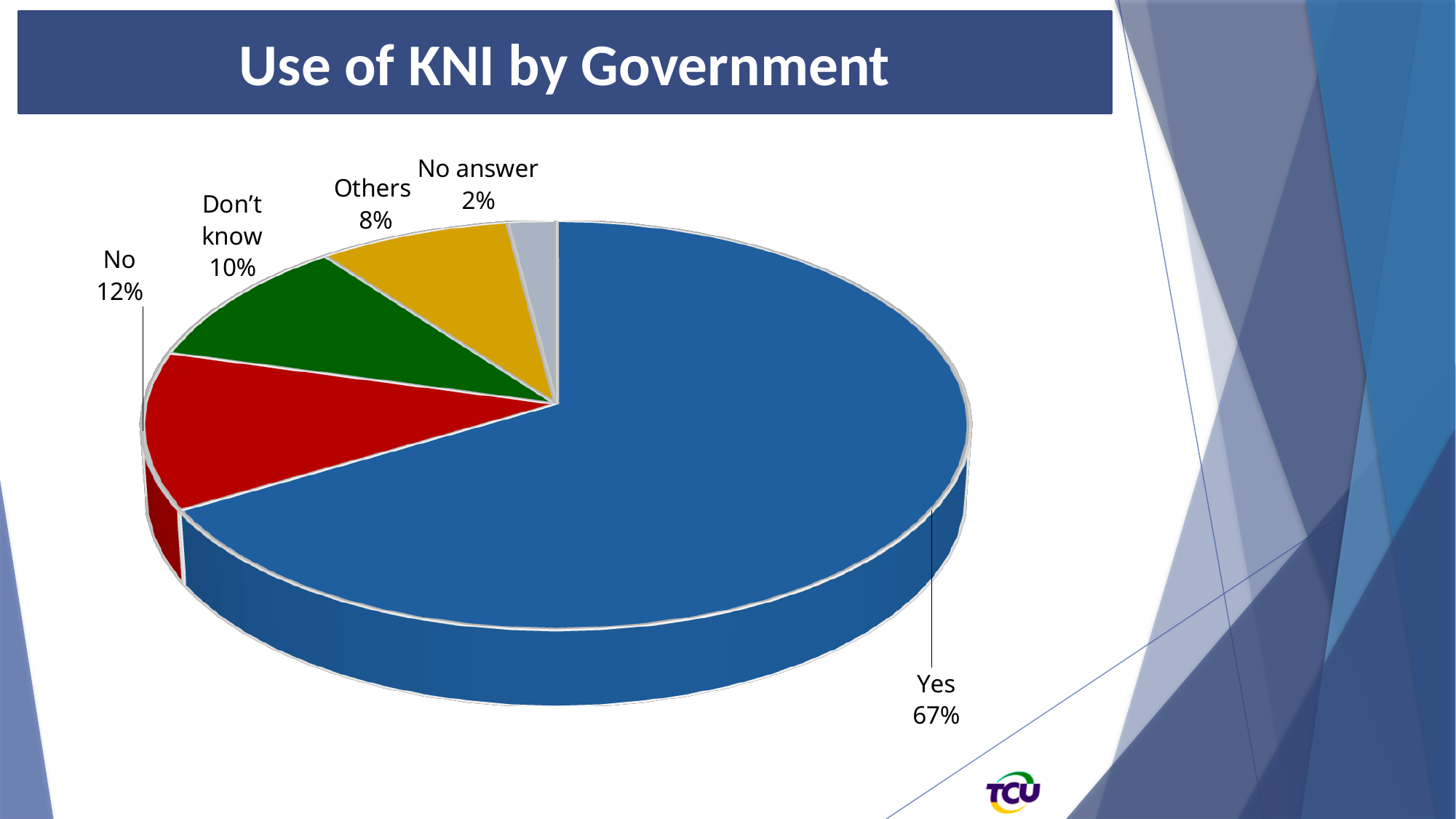
Which category has the smallest share of the pie? No answer Which is larger, the share for "No" or the share for "Don't know"? No Which category has the largest share of the pie? Yes What is the difference in percentage points between "Yes" and "No"? 55 What is the title of the slide containing the chart? Use of KNI by Government What percentage of respondents answered "No"? 12% What type of chart is shown on the slide? Pie chart What percentage of respondents answered "Yes"? 67% What percentage is shown for "No answer"? 2% What percentage is shown for "Others"? 8% How many categories are shown in the pie chart? 5 What percentage of respondents answered "Don't know"? 10%